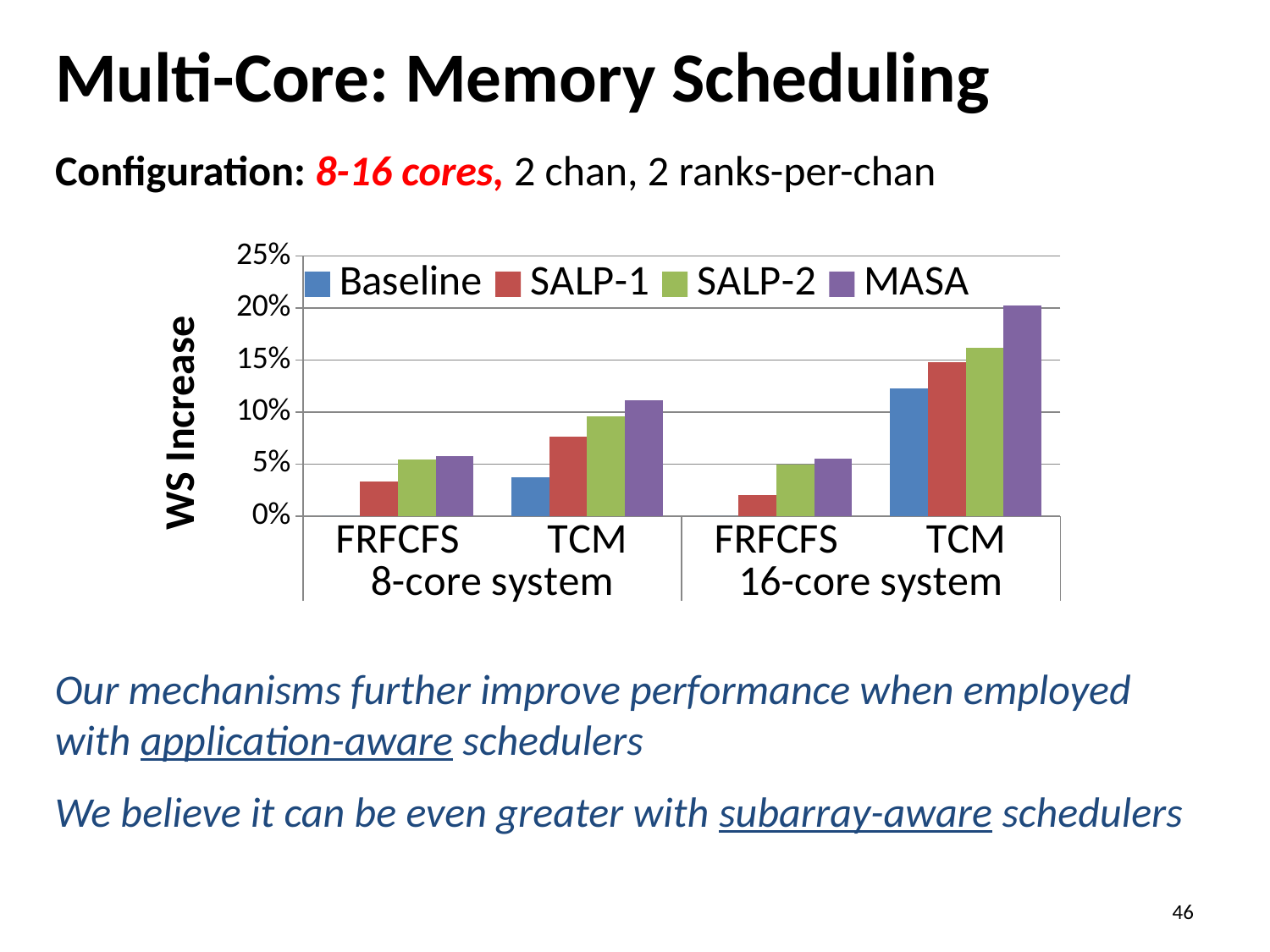
Is the value for Baseline with TCM in the 16-core system greater or less than 10%? greater For TCM in the 8-core system, which is larger: MASA or SALP-1? MASA Which series are listed in the legend? Baseline, SALP-1, SALP-2, MASA What kind of chart is shown on the slide? bar chart Is the value for SALP-1 with FRFCFS in the 8-core system greater or less than 5%? less What is the label of the y axis? WS Increase Is the value for MASA with TCM in the 8-core system greater or less than 10%? greater Which bar is the highest in the whole chart? MASA for TCM in the 16-core system For TCM in the 8-core system, which series has the lowest value? Baseline How many scheduler categories are shown along the x axis across both systems? 4 How many series does the legend list? 4